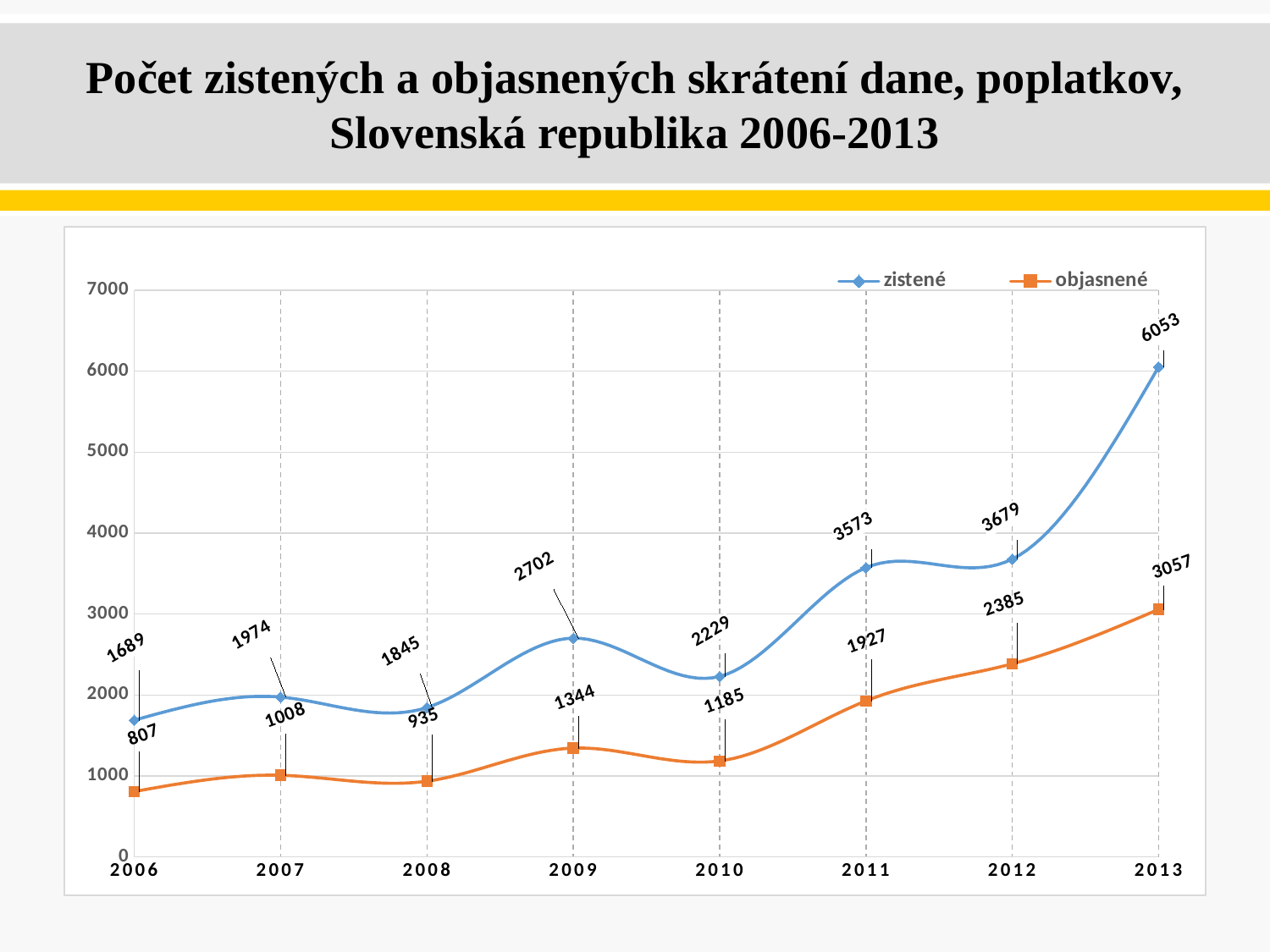
What is the value of objasnené in 2012? 2385 What kind of chart is shown on the slide? line chart How many years are shown on the x axis? 8 What is the difference between zistené and objasnené in 2013? 2996 How many series does the legend list? 2 What is the difference between zistené in 2012 and zistené in 2011? 106 In which year is objasnené lowest? 2006 What is the value of zistené in 2009? 2702 In which year is zistené highest? 2013 Does objasnené rise or fall from 2010 to 2013? rise Which is larger: objasnené in 2007 or objasnené in 2008? objasnené in 2007 Is the value of zistené in 2011 greater or less than 3000? greater